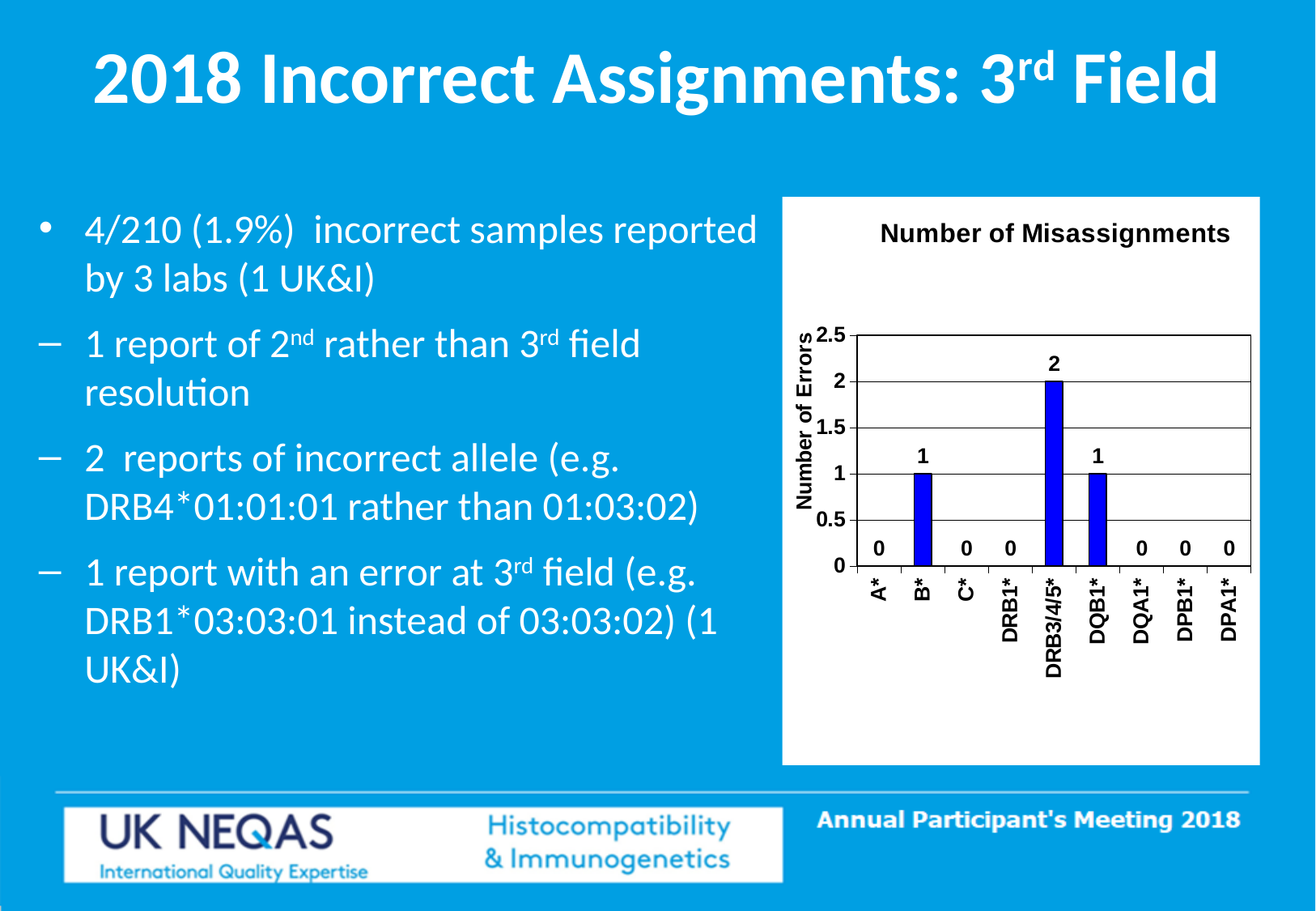
What is the difference in number of errors between DRB3/4/5* and B*? 1 What is the label of the y axis of the chart? Number of Errors What kind of chart is shown on the slide? Bar chart What is the number of errors for DPB1*? 0 How many categories are shown on the x axis of the chart? 9 Which category has the highest number of errors? DRB3/4/5* What is the number of errors for B*? 1 What is the number of errors for DRB3/4/5*? 2 What is the title of the chart? Number of Misassignments How many categories in the chart have 0 errors? 6 Which has more errors, DRB3/4/5* or DQB1*? DRB3/4/5* What is the number of errors for DQB1*? 1